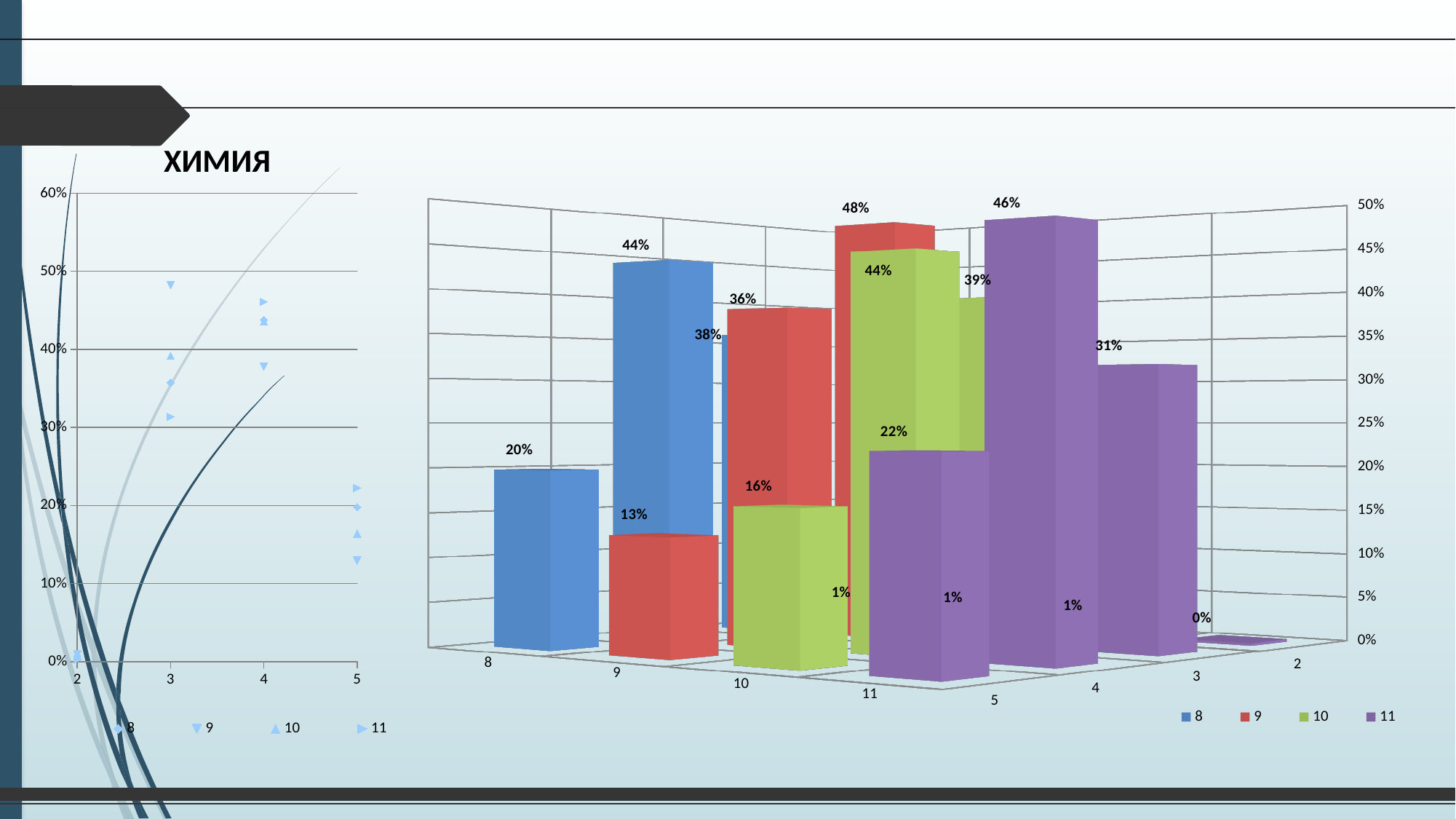
What is the title of the chart on the left? ХИМИЯ In the chart on the right, what is the difference between the tallest bar of series 9 (48%) and the tallest bar of series 11 (46%)? 2% What kind of chart is the chart on the left? scatter chart In the chart on the right, which series has the bar with the highest value? 9 How many series does the legend of the right chart list? 4 In the chart on the right, what is the value on the tallest bar of series 8? 44% What kind of chart is the chart on the right? bar chart In the chart on the right, which is larger: the tallest bar of series 8 or the tallest bar of series 11? series 11 In the chart on the right, what is the value on the tallest bar of series 11? 46% How many series does the legend of the left chart list? 4 In the chart on the right, what is the highest data label shown? 48% In the chart on the right, what is the lowest data label shown? 0%